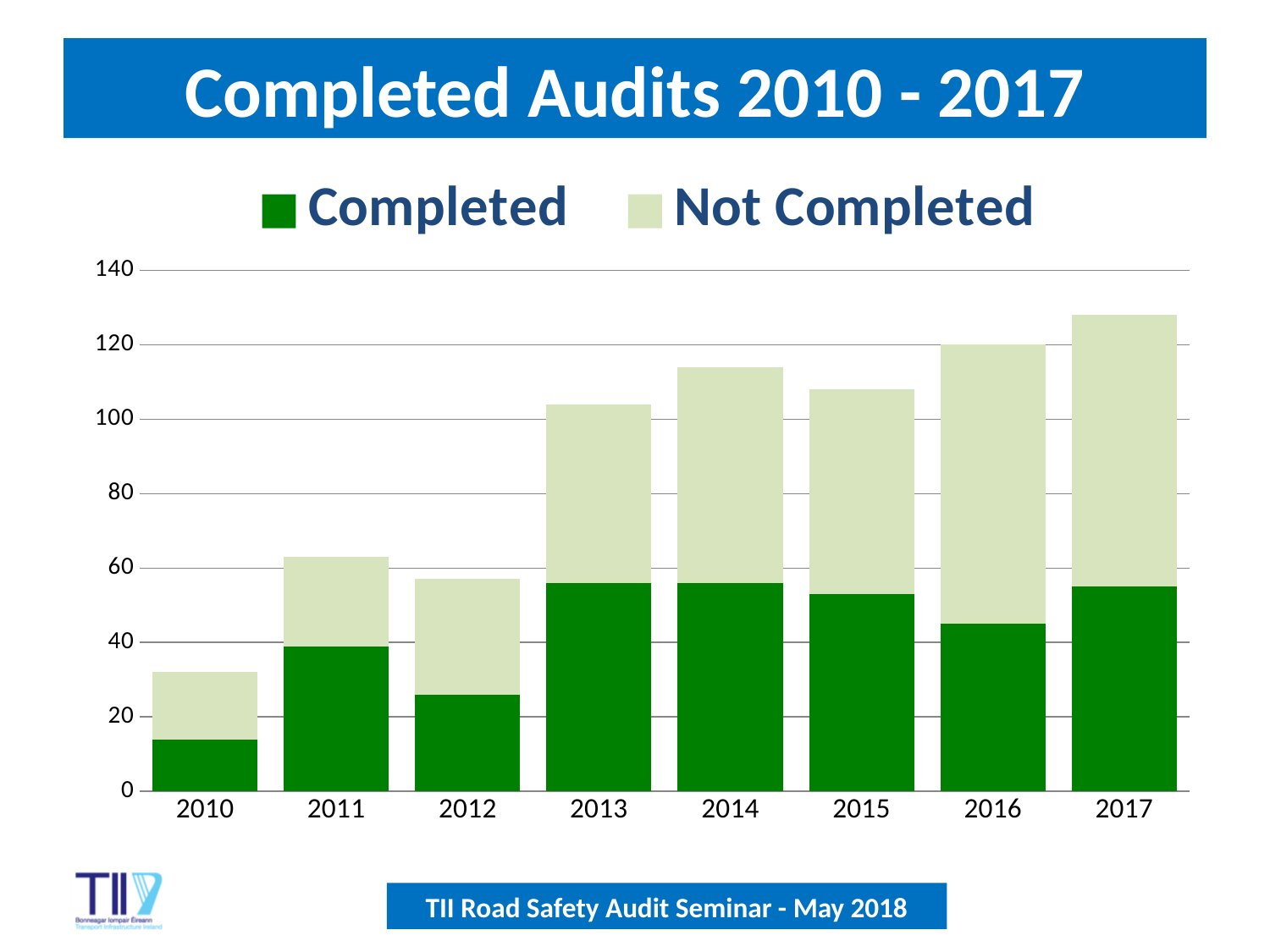
Which year has the smallest Completed value? 2010 Is the Completed value for 2016 greater or less than 40? greater Which year has the larger total bar, 2015 or 2016? 2016 What kind of chart is shown on the slide? Stacked bar chart What is the title of the chart on the slide? Completed Audits 2010 - 2017 Which year has the shortest stacked bar overall? 2010 Which year has the larger Completed value, 2016 or 2017? 2017 Which year has the tallest stacked bar overall? 2017 Is the total bar height for 2017 greater or less than 120? greater How many years are shown along the x axis of the chart? 8 How many series does the chart's legend list? 2 Is the total bar height for 2010 greater or less than 40? less